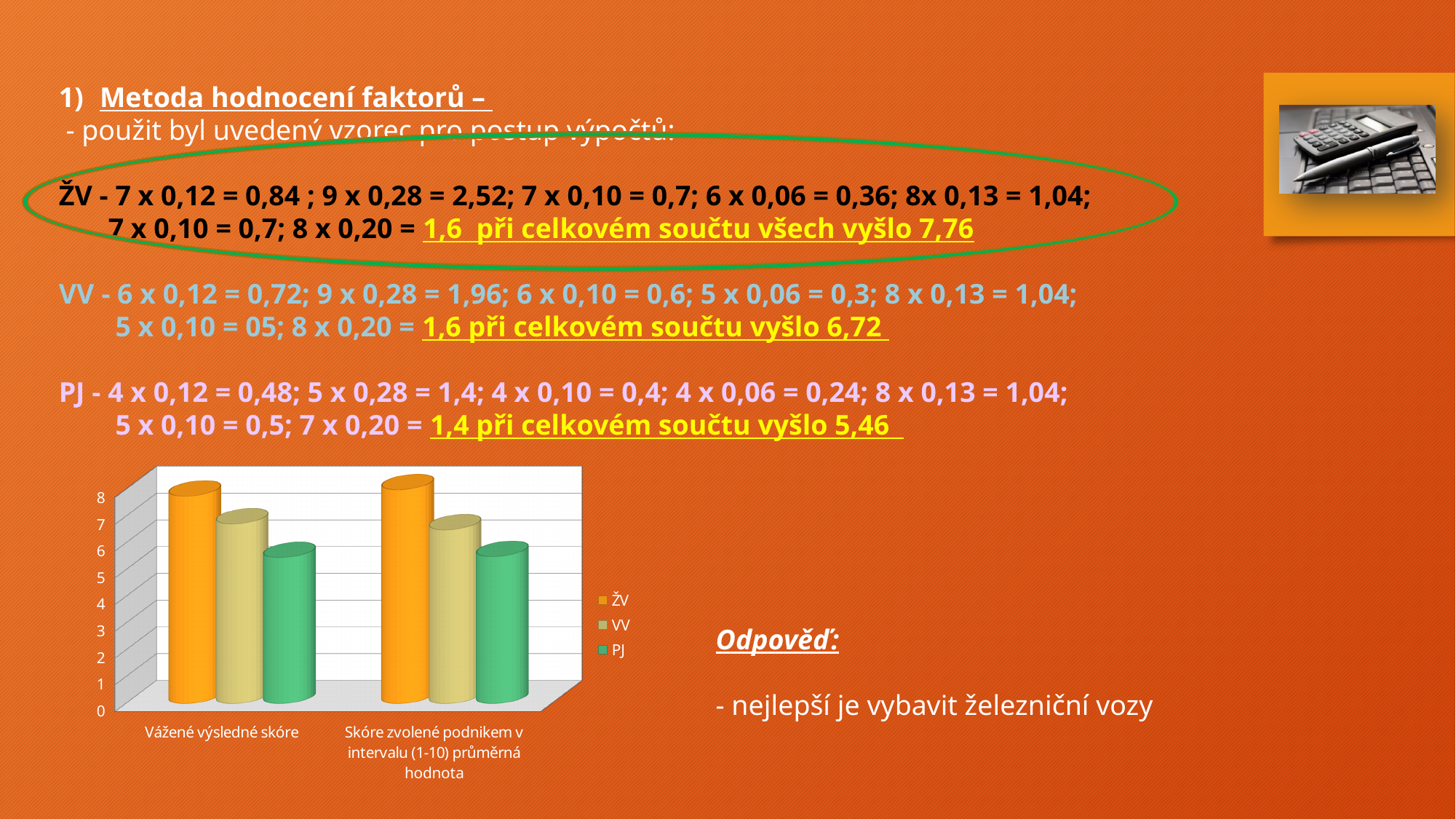
Which series has the lowest bar in the 'Vážené výsledné skóre' category? PJ Which series has the highest bar in the 'Vážené výsledné skóre' category? ŽV How many categories are shown on the x axis of the chart? 2 Is the value for VV in the 'Vážené výsledné skóre' category greater or less than 6? greater Which series has the highest bar in the 'Skóre zvolené podnikem v intervalu (1-10) průměrná hodnota' category? ŽV What kind of chart is shown on the slide? bar chart In the 'Vážené výsledné skóre' category, is the bar for ŽV or for VV taller? ŽV Is the value for PJ in the 'Vážené výsledné skóre' category greater or less than 6? less Is the value for ŽV in the 'Vážené výsledné skóre' category greater or less than 7? greater What colour are the bars for the ŽV series in the chart? orange How many series does the chart legend list? 3 Which series has the lowest bar in the 'Skóre zvolené podnikem v intervalu (1-10) průměrná hodnota' category? PJ